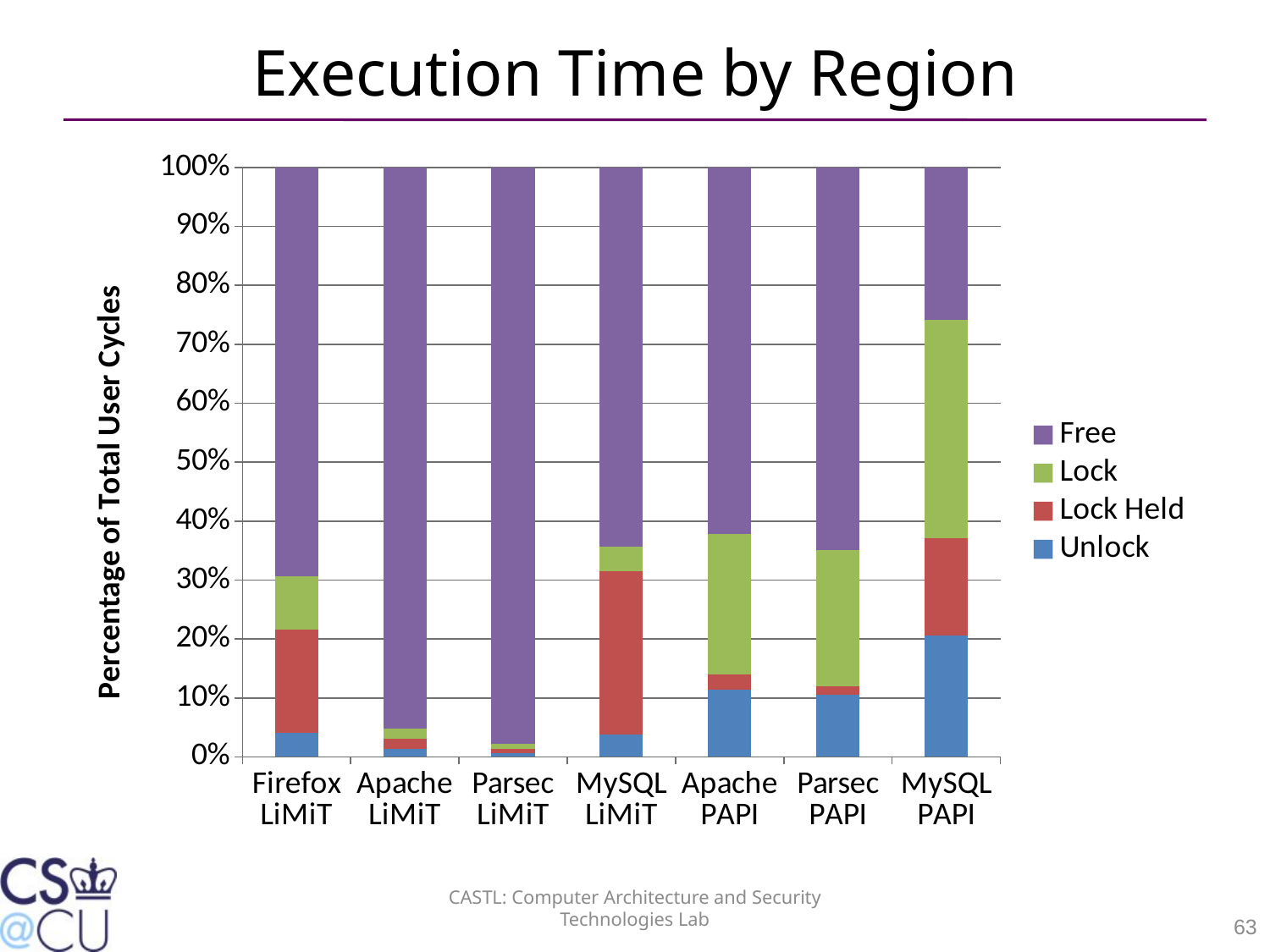
Which bar has the smallest Free segment? MySQL PAPI How many bars (benchmark configurations) are shown along the x axis? 7 What is the total of each stacked bar? 100% How many series does the legend list? 4 Is the Unlock value for Firefox LiMiT greater or less than 10%? less What kind of chart is shown on the slide? Stacked bar chart Which bar has the largest Unlock segment? MySQL PAPI Is the Unlock value for MySQL PAPI greater or less than 10%? greater Which bar has the largest Lock segment? MySQL PAPI What is the y-axis title of the chart? Percentage of Total User Cycles Which is larger, the Lock Held segment for MySQL LiMiT or for Firefox LiMiT? MySQL LiMiT Which bar has the largest Lock Held segment? MySQL LiMiT